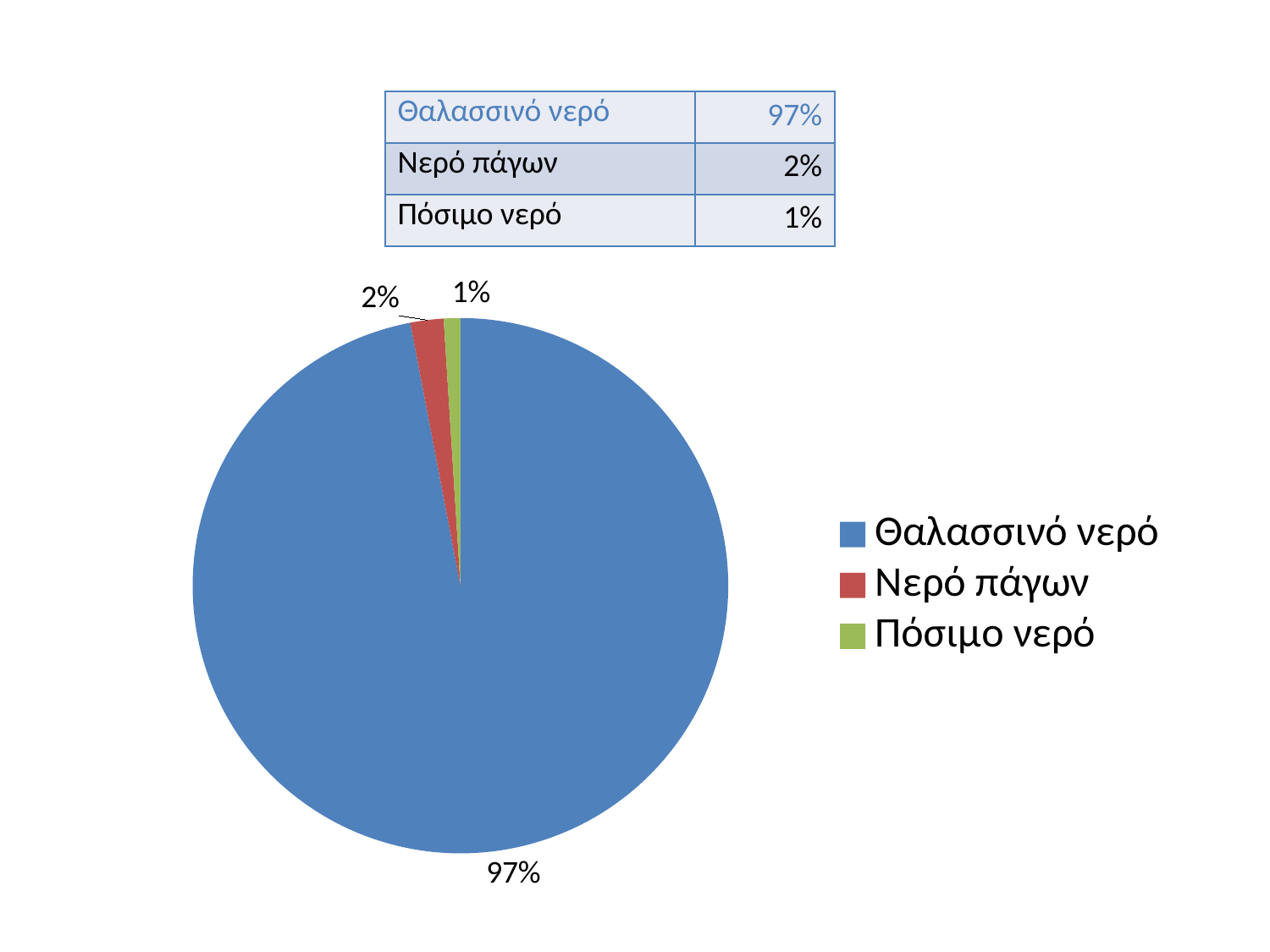
What share of the pie does Θαλασσινό νερό have? 97% What is the difference between the shares of Νερό πάγων and Πόσιμο νερό? 1% How many entries does the legend list? 3 What colour is the slice for Πόσιμο νερό? green Which category has the smallest slice of the pie? Πόσιμο νερό How many slices does the pie chart have? 3 What is the difference between the shares of Θαλασσινό νερό and Νερό πάγων? 95% What kind of chart is shown on the slide? pie chart Which is larger, the slice for Νερό πάγων or the slice for Πόσιμο νερό? Νερό πάγων Which category has the largest slice of the pie? Θαλασσινό νερό What share of the pie does Πόσιμο νερό have? 1% What share of the pie does Νερό πάγων have? 2%